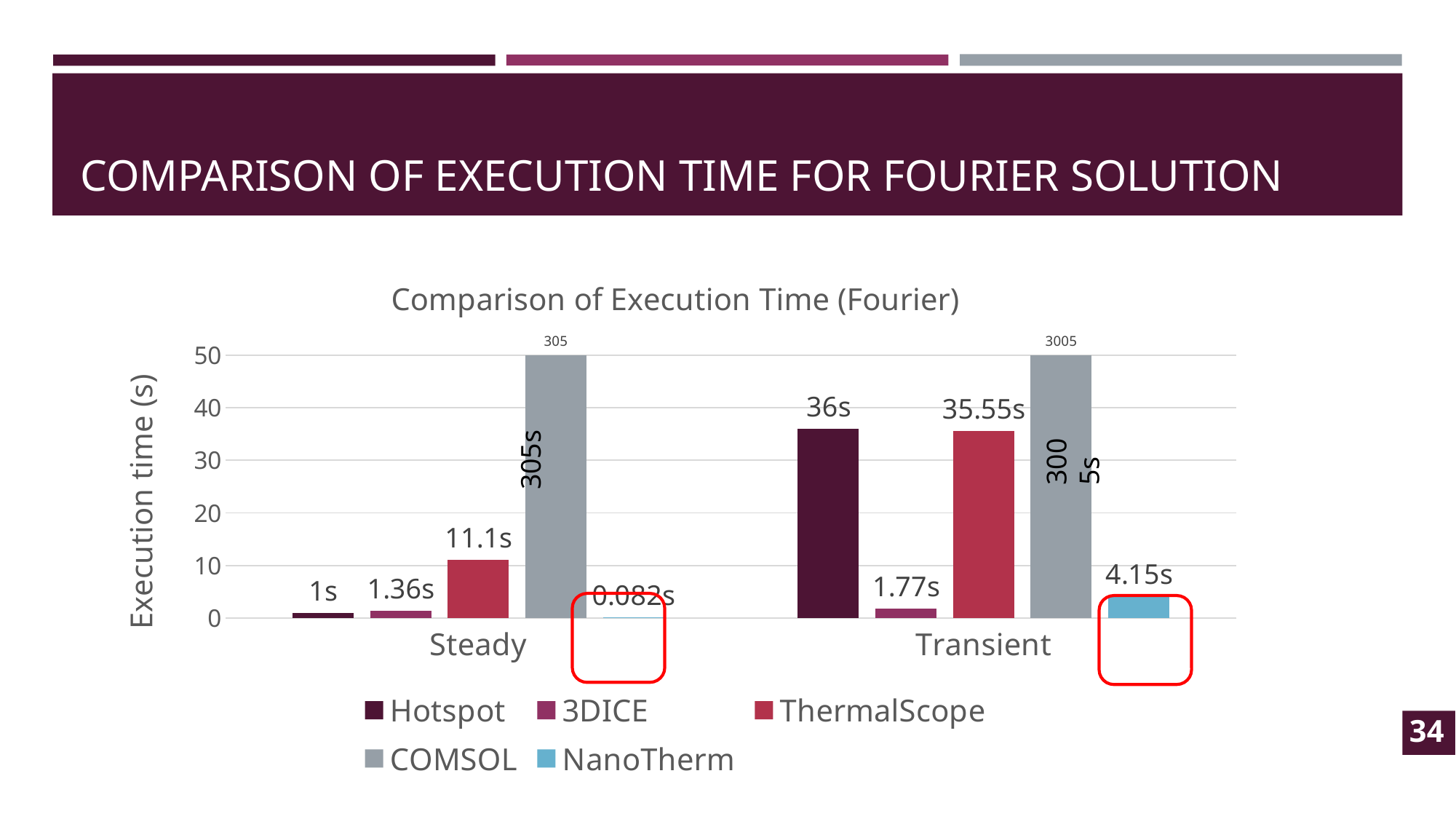
How many series does the legend list? 5 What is the execution time for ThermalScope in the Steady case? 11.1s How many categories are shown on the x axis? 2 What is the execution time for COMSOL in the Transient case? 3005s What is the execution time for Hotspot in the Steady case? 1s Which is larger in the Transient case, the execution time for Hotspot or for ThermalScope? Hotspot Which tool has the highest execution time in the Transient case? COMSOL Which tool has the lowest execution time in the Steady case? NanoTherm What type of chart is shown on the slide? Bar chart What is the execution time for 3DICE in the Transient case? 1.77s What is the difference between the Transient and Steady execution times for Hotspot? 35s What is the execution time for NanoTherm in the Transient case? 4.15s